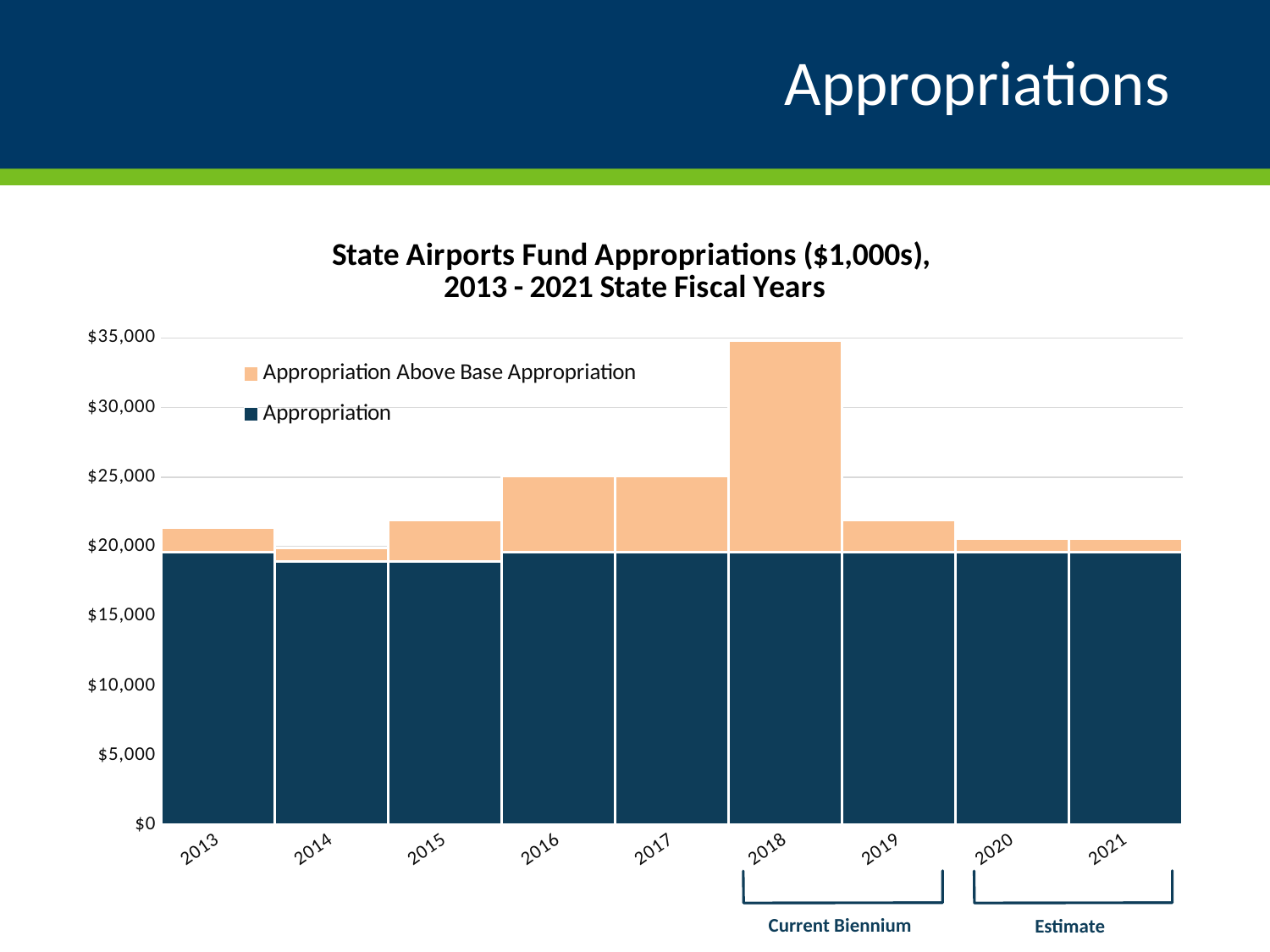
How many fiscal years are shown on the x axis of the chart? 9 Which fiscal year has the lowest total appropriation in the chart? 2014 Which has the larger total appropriation, 2017 or 2018? 2018 Do the total appropriations rise or fall from 2018 to 2021? fall Is the total appropriation for 2013 greater or less than $20,000? greater What is the title of the chart? State Airports Fund Appropriations ($1,000s), 2013 - 2021 State Fiscal Years Is the total appropriation for 2018 greater or less than $30,000? greater Which fiscal year has the highest total appropriation in the chart? 2018 Which fiscal years are labelled as the "Current Biennium" below the chart? 2018 and 2019 What kind of chart is shown on the slide? Stacked bar chart How many series does the chart's legend list? 2